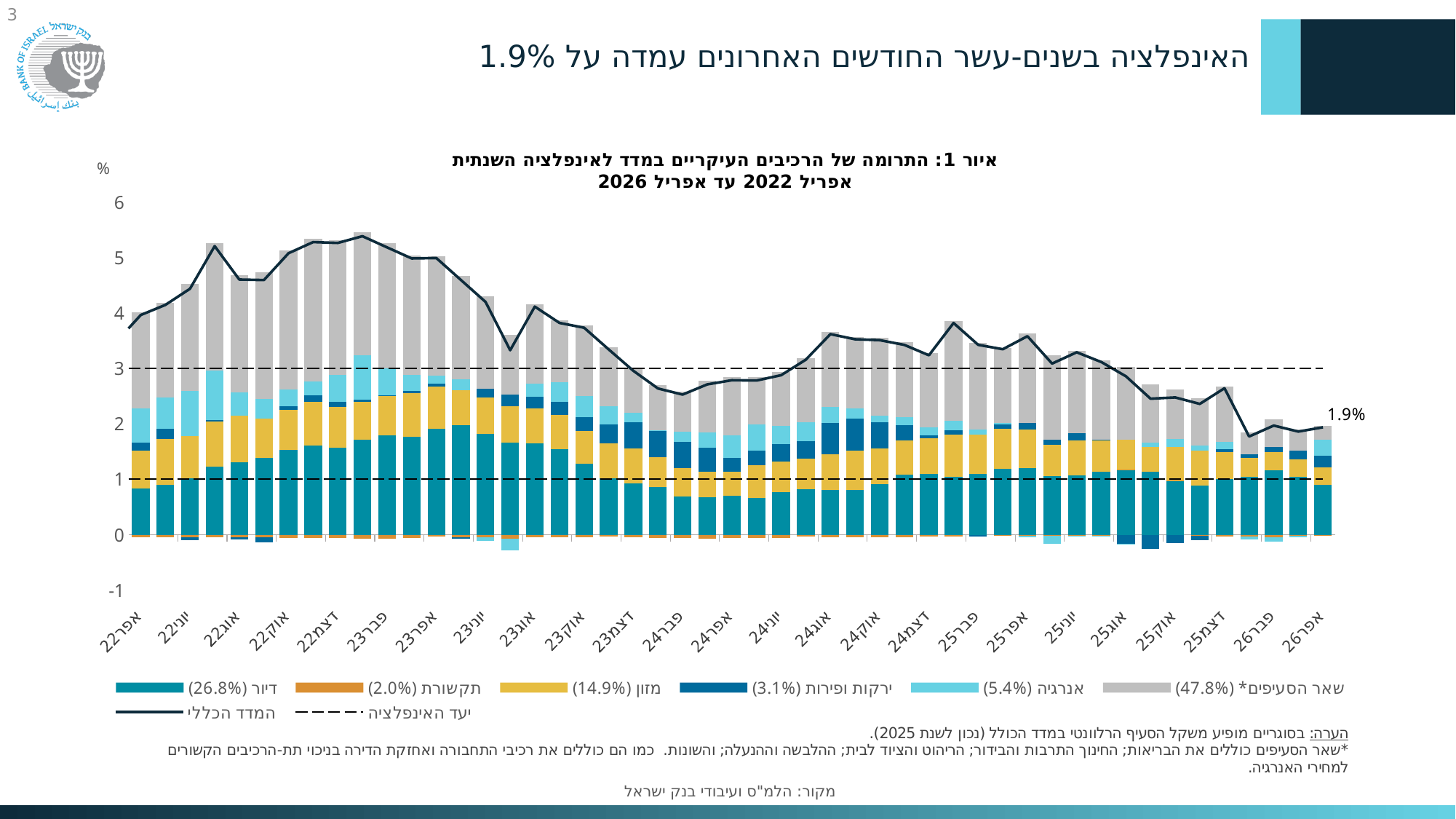
Is the overall index (המדד הכללי) in February 2024 (פבר 24) greater or less than 3? less How many entries does the legend list? 8 What kind of chart is shown on the slide? Stacked bar chart with a line Is the housing (דיור) contribution in February 2023 (פבר 23) greater or less than 1? greater Does the overall index (המדד הכללי) rise or fall between February 2023 (פבר 23) and February 2024 (פבר 24)? fall Is the overall index (המדד הכללי) in August 2025 (אוג 25) greater or less than 4? less Which is higher, the overall index (המדד הכללי) in April 2022 (אפר 22) or in April 2026 (אפר 26)? April 2022 (אפר 22) What is the value of the overall index (המדד הכללי) labelled at the end of the series, in April 2026 (אפר 26)? 1.9% What weight is shown in the legend for the other items (שאר הסעיפים*)? 47.8% What weight is shown in the legend for housing (דיור)? 26.8%